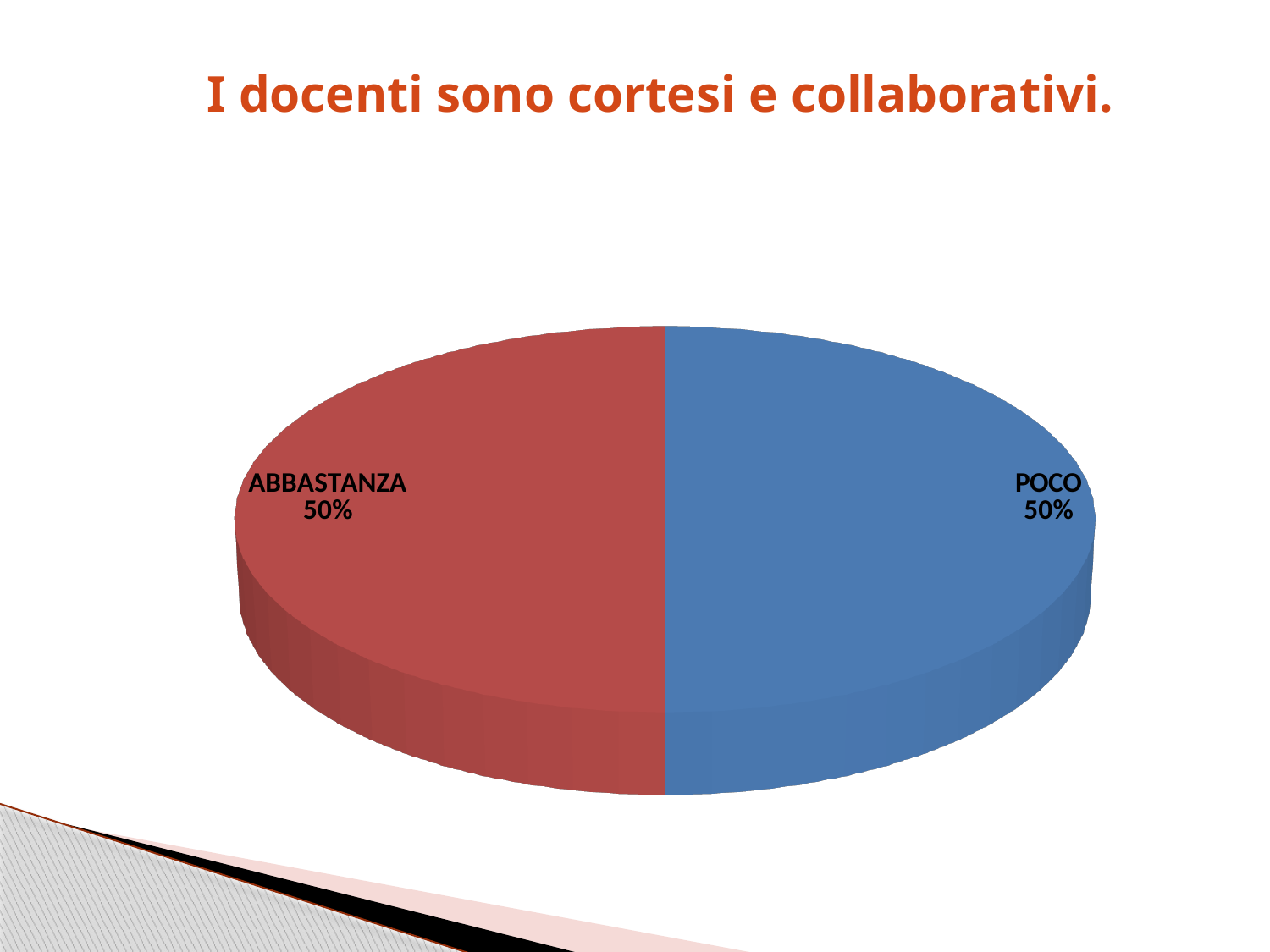
What is the value shown for the ABBASTANZA slice? 50% What share of the pie does ABBASTANZA represent? 50% What is the title of the slide? I docenti sono cortesi e collaborativi. What kind of chart is shown on the slide? Pie chart How many slices does the pie chart have? 2 What is the value shown for the POCO slice? 50% What is the difference between the ABBASTANZA and POCO shares? 0% What share of the pie does POCO represent? 50% What colour is the POCO slice? Blue What is the combined share of ABBASTANZA and POCO? 100%